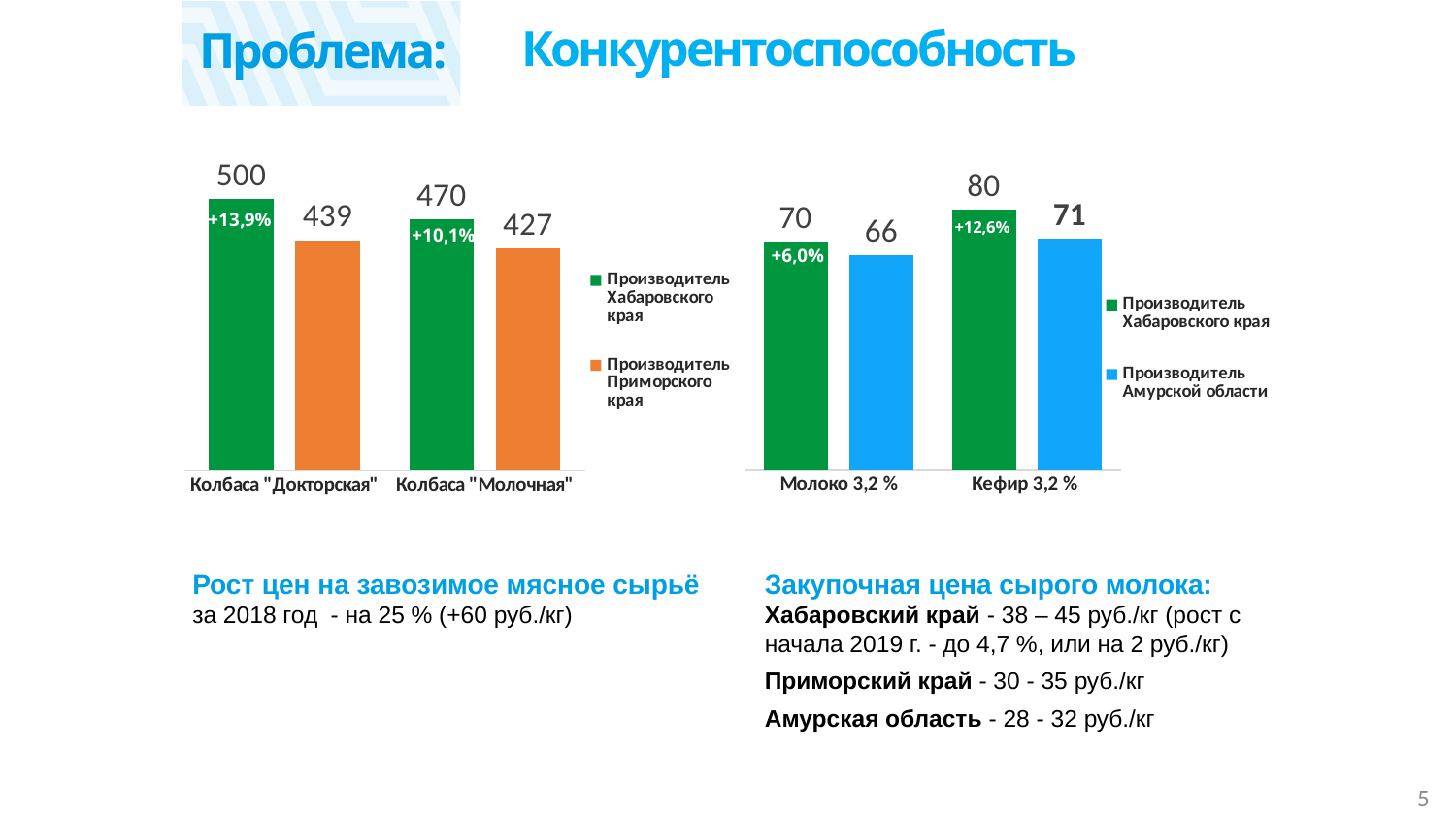
In the left chart, what is the difference between the two producers' values for Колбаса "Докторская"? 61 In the right chart, which category has the highest value overall? Кефир 3,2 % In the right chart, what is the value for Производитель Хабаровского края for Кефир 3,2 %? 80 In the left chart, what percentage label is shown on the Хабаровский край bar for Колбаса "Докторская"? +13,9% What type of chart is the right chart? Bar chart In the left chart, what is the value for Производитель Приморского края for Колбаса "Молочная"? 427 In the right chart, how many categories are shown on the x axis? 2 In the left chart, how many series does the legend list? 2 In the right chart, what is the value for Производитель Амурской области for Молоко 3,2 %? 66 In the left chart, which producer has the higher value for Колбаса "Молочная"? Производитель Хабаровского края In the right chart, what is the difference between the two producers' values for Кефир 3,2 %? 9 In the left chart, what is the value for Производитель Хабаровского края for Колбаса "Докторская"? 500